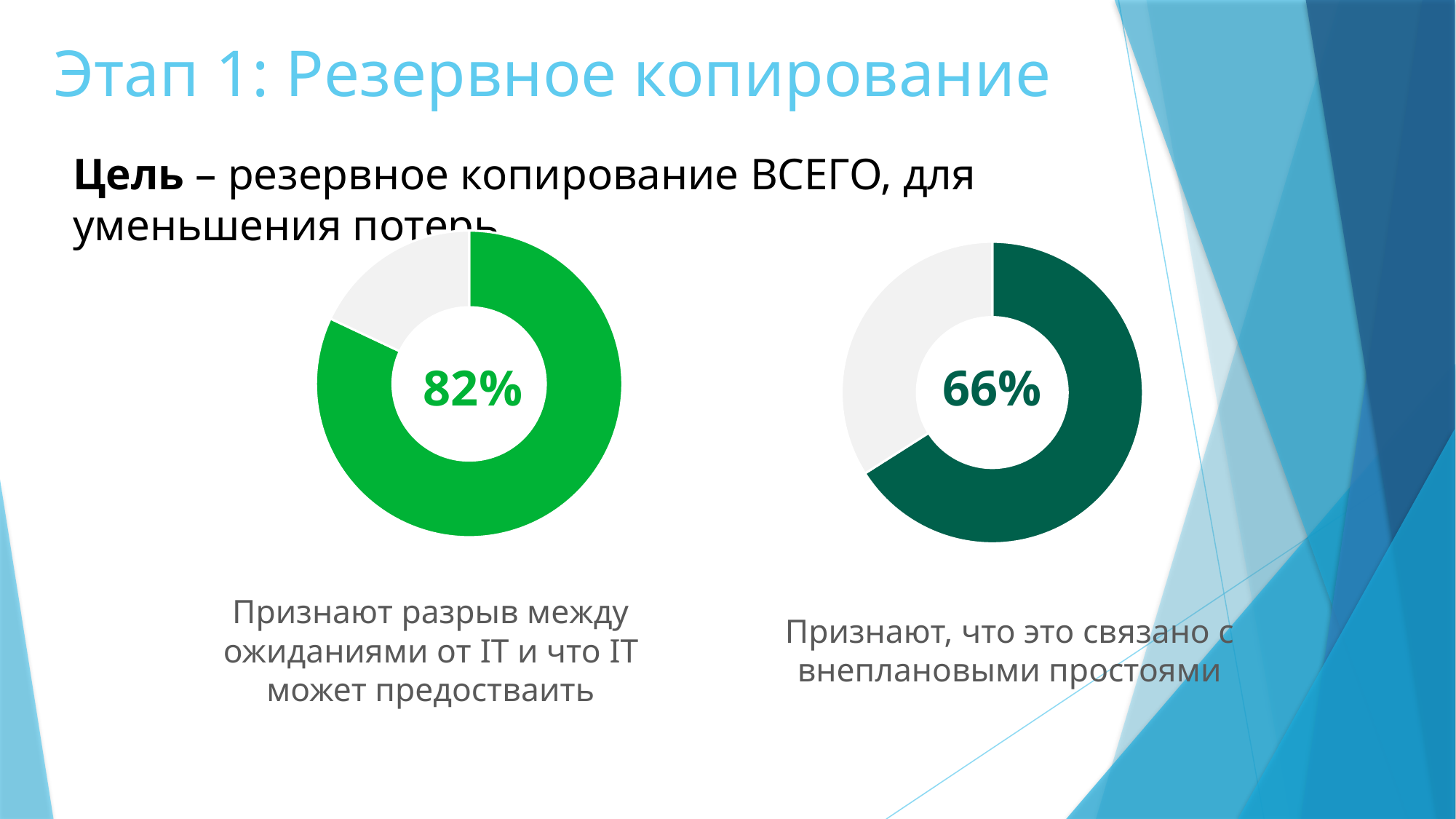
What is the difference in percentage points between the value in the left chart and the value in the right chart? 16 What colour is the highlighted segment of the right donut chart? dark green How many segments does the left donut chart have? 2 What percentage of respondents recognise the gap between expectations from IT and what IT can deliver (left chart)? 82% In the right chart, what share of the ring is not filled with the dark green colour? 34% What percentage of respondents recognise that this is related to unplanned downtime (right chart)? 66% Which chart shows the larger highlighted share, the left one or the right one? the left one What kind of chart is used on this slide? donut (pie) chart What value is shown in the centre of the right donut chart? 66% In the left chart, what share of the ring is not filled with the bright green colour? 18% What value is shown in the centre of the left donut chart? 82% How many charts are on the slide? 2